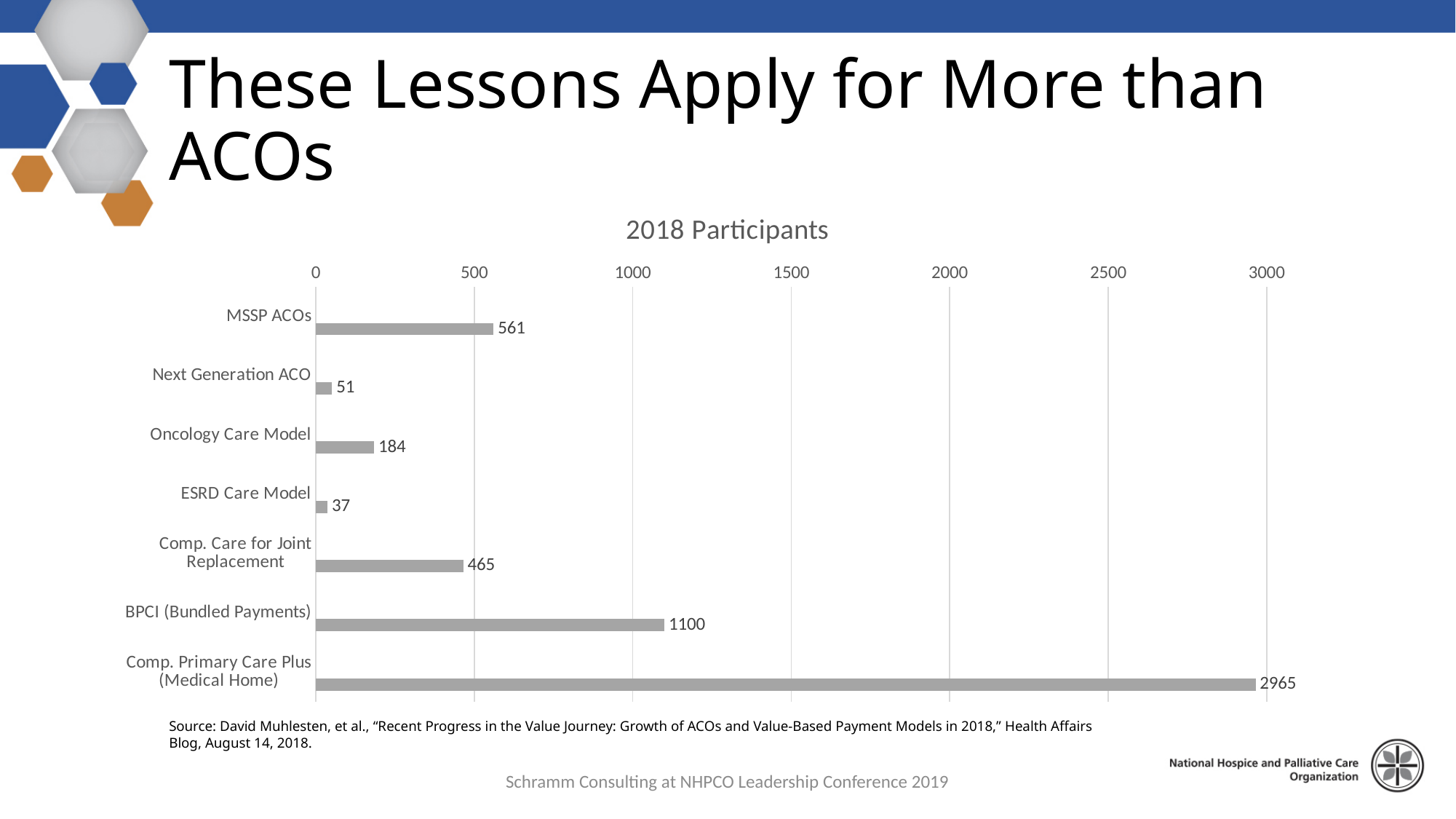
Which is larger, the value for Next Generation ACO or the value for ESRD Care Model? Next Generation ACO Which category has the highest number of 2018 participants? Comp. Primary Care Plus (Medical Home) What is the value for BPCI (Bundled Payments)? 1100 Which category has the lowest number of 2018 participants? ESRD Care Model What is the difference between the values for Comp. Primary Care Plus (Medical Home) and BPCI (Bundled Payments)? 1865 What is the value for MSSP ACOs? 561 Is the value for BPCI (Bundled Payments) greater or less than 1000? greater What is the difference between the values for MSSP ACOs and Comp. Care for Joint Replacement? 96 What kind of chart is shown on the slide? bar chart What is the value for Oncology Care Model? 184 How many categories are shown in the chart? 7 What is the title of the chart? 2018 Participants